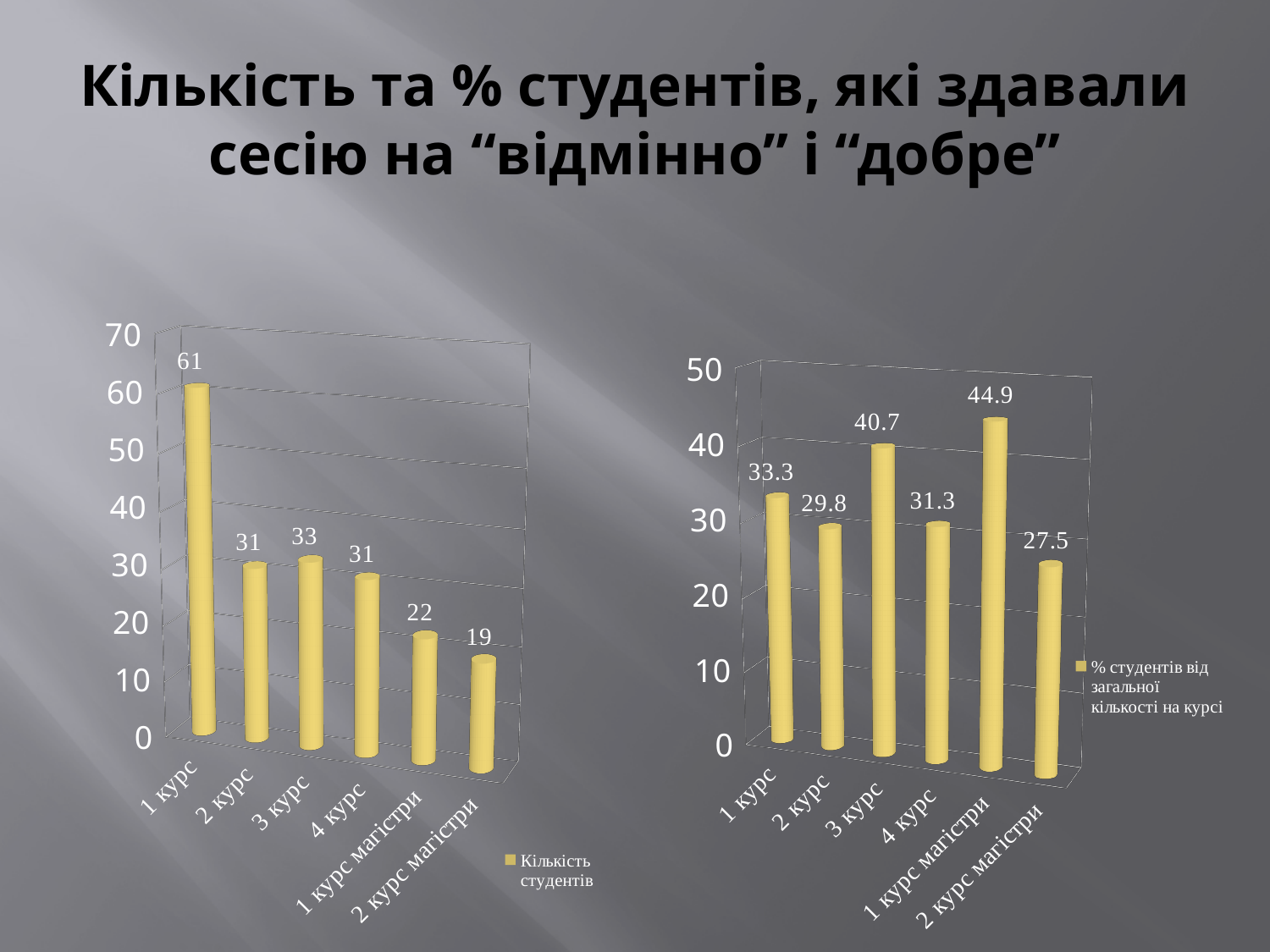
In the left chart (Кількість студентів), what is the value for 1 курс магістри? 22 In the left chart (Кількість студентів), what is the difference between the values for 1 курс and 3 курс? 28 In the right chart (% студентів від загальної кількості на курсі), what is the difference between the values for 1 курс магістри and 2 курс магістри? 17.4 In the left chart (Кількість студентів), what is the value for 1 курс? 61 In the left chart (Кількість студентів), how many categories are shown on the x axis? 6 What is the legend entry of the right chart? % студентів від загальної кількості на курсі In the right chart (% студентів від загальної кількості на курсі), which category has the highest value? 1 курс магістри What kind of chart is the left chart? bar chart In the right chart (% студентів від загальної кількості на курсі), which category has the lowest value? 2 курс магістри In the left chart (Кількість студентів), which category has the lowest value? 2 курс магістри In the right chart (% студентів від загальної кількості на курсі), what is the value for 3 курс? 40.7 In the right chart (% студентів від загальної кількості на курсі), which is larger: the value for 1 курс or the value for 4 курс? 1 курс